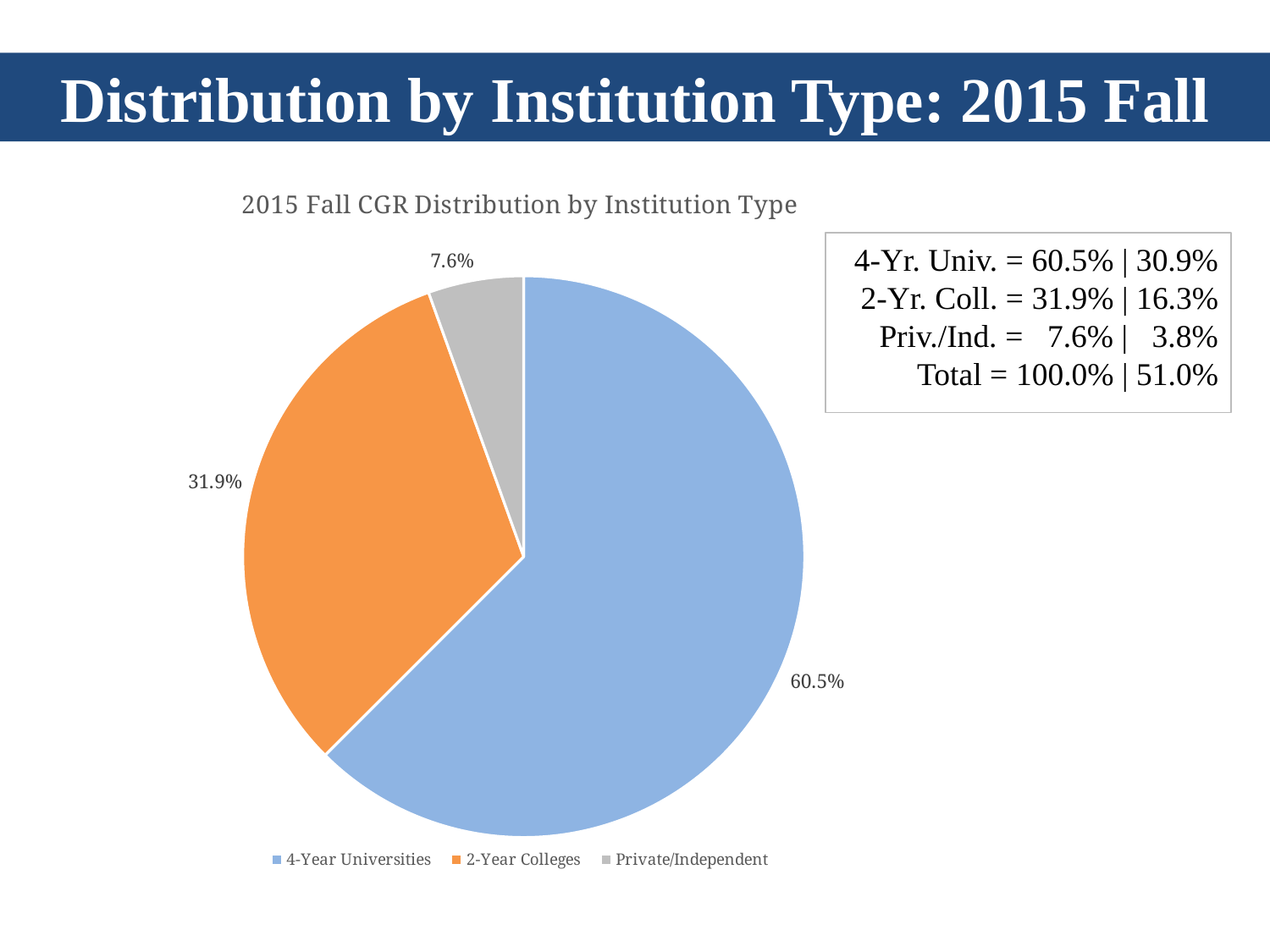
What is the title of the chart? 2015 Fall CGR Distribution by Institution Type What is the value shown for 2-Year Colleges? 31.9% What is the difference between the 4-Year Universities share and the 2-Year Colleges share? 28.6% What colour is the slice for 2-Year Colleges? Orange Which category has the smallest slice of the pie? Private/Independent What share of the pie does 4-Year Universities hold? 60.5% What kind of chart is shown on the slide? Pie chart Which category has the largest slice of the pie? 4-Year Universities What is the value shown for Private/Independent? 7.6% Which is larger, the share for 2-Year Colleges or the share for Private/Independent? 2-Year Colleges What is the difference between the 2-Year Colleges share and the Private/Independent share? 24.3% How many categories are shown in the pie chart? 3